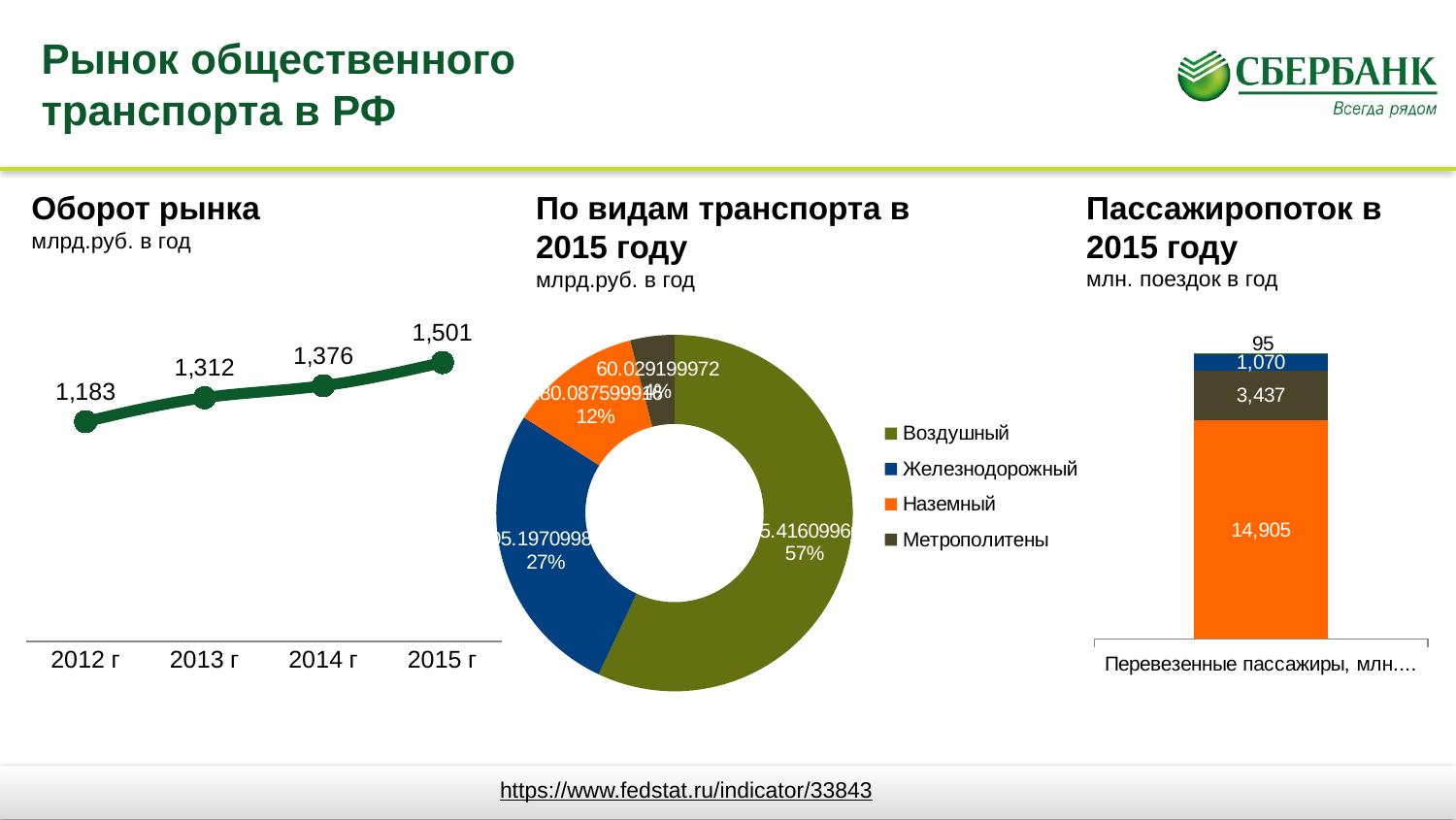
In the 'Пассажиропоток в 2015 году' chart, what is the value of the largest segment of the stacked bar? 14,905 In the 'По видам транспорта в 2015 году' chart, what share does Железнодорожный have? 27% How many data points are plotted in the 'Оборот рынка' chart? 4 In the 'Оборот рынка' chart, what is the value for 2015 г? 1,501 How many entries does the legend of the 'По видам транспорта в 2015 году' chart list? 4 In the 'Оборот рынка' chart, what is the value for 2012 г? 1,183 In the 'Оборот рынка' chart, do the values rise or fall from 2012 г to 2015 г? rise In the 'Пассажиропоток в 2015 году' chart, what is the total of the stacked bar? 19,507 In the 'Оборот рынка' chart, which year has the lowest value? 2012 г In the 'По видам транспорта в 2015 году' chart, what share does Воздушный have? 57% In the 'Оборот рынка' chart, what is the difference between the 2015 г and 2012 г values? 318 What kind of chart is 'Оборот рынка'? line chart